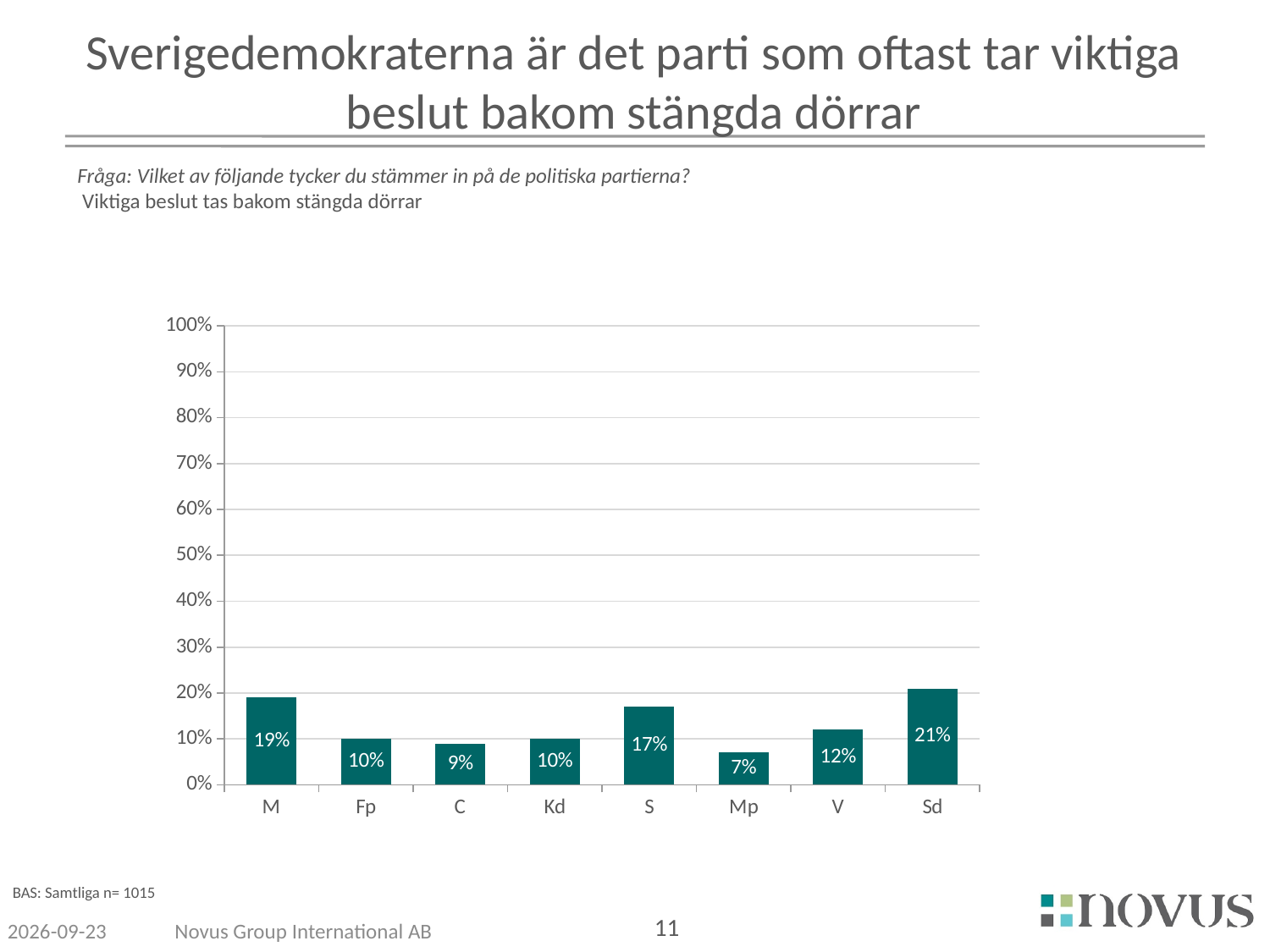
What is the value for V? 12% How many parties are shown on the x axis? 8 What kind of chart is shown? bar chart What is the difference between the values for S and Mp? 10% What is the value for Sd? 21% What is the difference between the values for Sd and M? 2% Which party has the highest value? Sd Which is larger, the value for S or the value for V? S What is the highest value shown on the y axis? 100% Which party has the lowest value? Mp What is the value for Mp? 7% What is the value for M? 19%